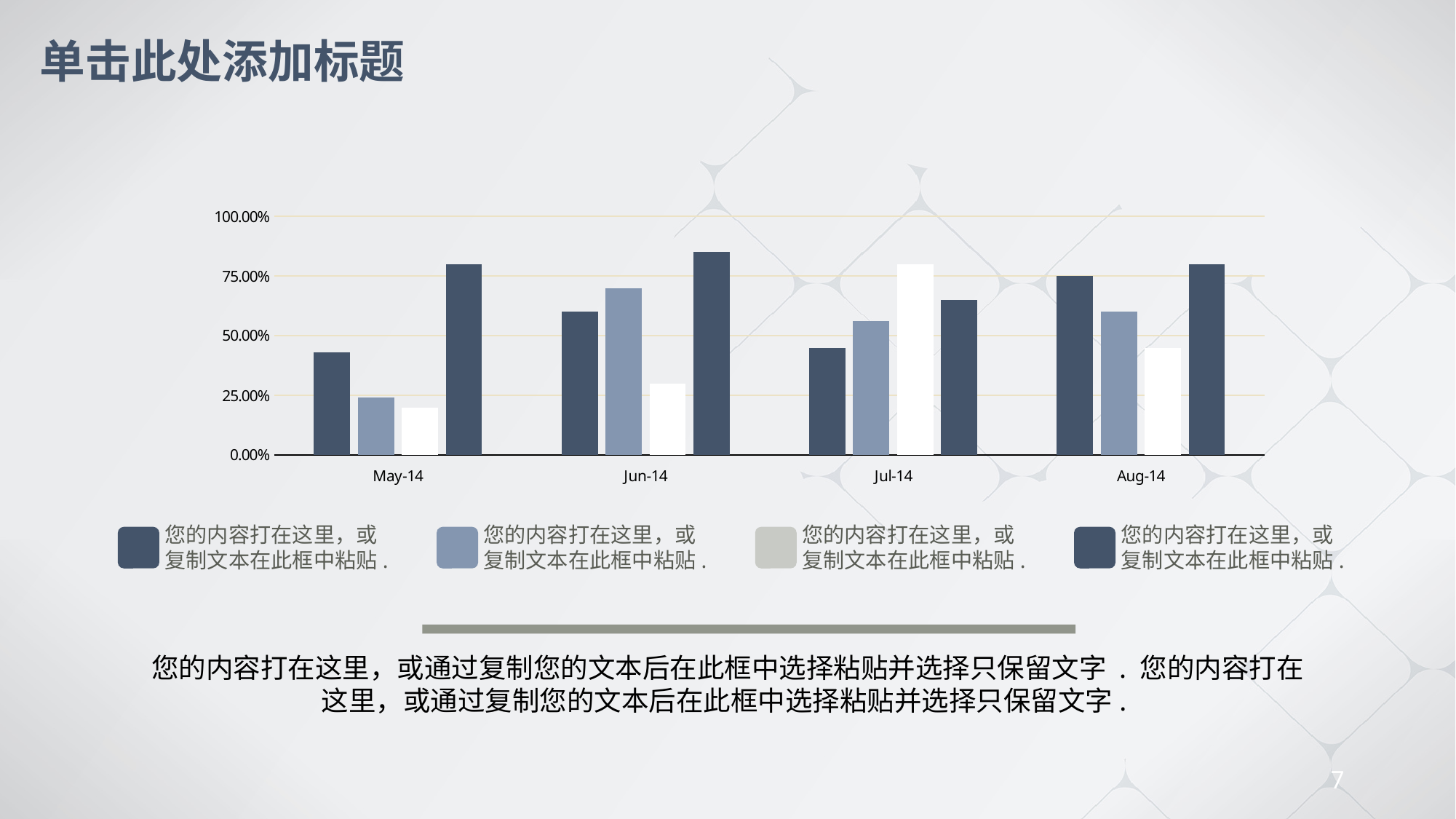
What kind of chart is shown on the slide? bar chart For the fourth (rightmost) bar series, which category has the highest value? Jun-14 How many series does the chart's legend list? 4 Is the value of the fourth (rightmost) bar in the Jun-14 group greater or less than 75.00%? greater Is the value of the third (white) bar in the May-14 group greater or less than 25.00%? less Is the value of the fourth (rightmost) bar in the May-14 group greater or less than 75.00%? greater For the fourth (rightmost) bar series, which category has the lowest value? Jul-14 How many categories are shown on the x axis of the chart? 4 In the May-14 group, which is larger: the first (leftmost) bar or the fourth (rightmost) bar? the fourth (rightmost) bar